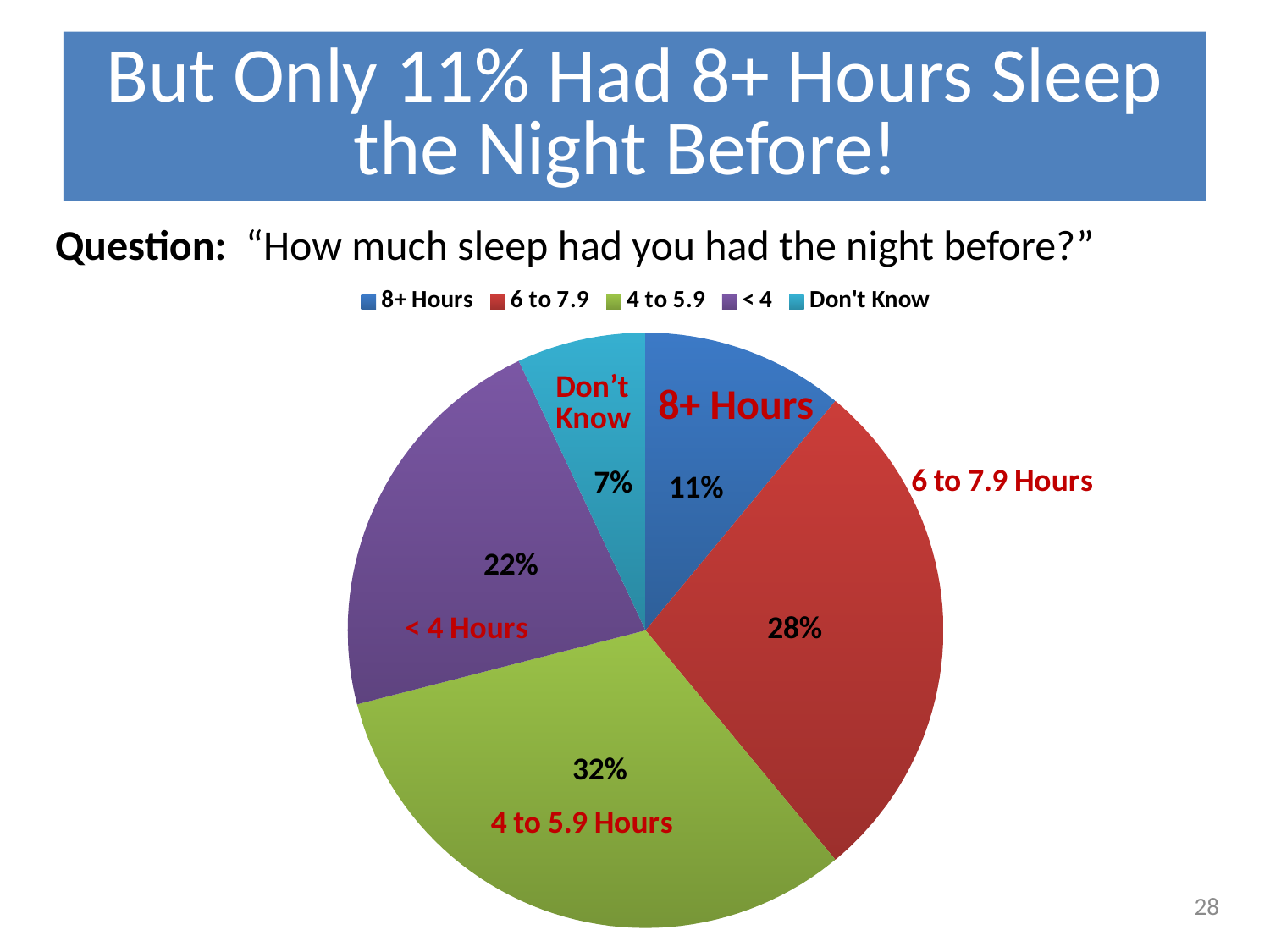
What percentage of respondents had 8+ hours of sleep? 11% Which category has the smallest share of the pie? Don't Know Which category has the largest share of the pie? 4 to 5.9 Hours What kind of chart is shown on the slide? pie chart What percentage of respondents answered Don't Know? 7% What percentage of respondents had less than 4 hours of sleep? 22% What percentage of respondents had 4 to 5.9 hours of sleep? 32% What colour is the slice for 4 to 5.9 Hours? green How many categories does the legend list? 5 What is the difference in percentage points between the 4 to 5.9 Hours slice and the 8+ Hours slice? 21 What percentage of respondents had 6 to 7.9 hours of sleep? 28% Which is larger, the share for 6 to 7.9 Hours or the share for < 4 Hours? 6 to 7.9 Hours